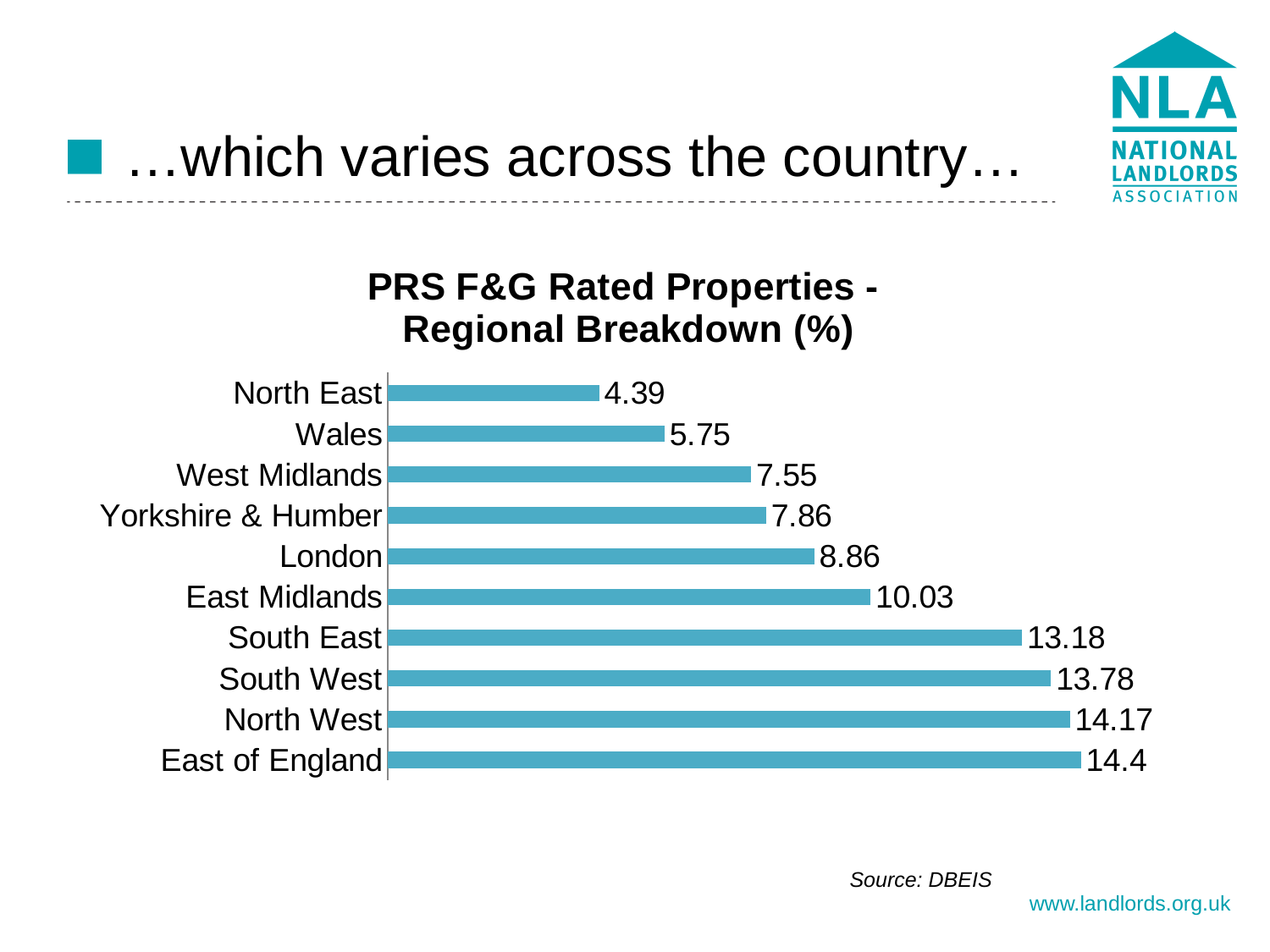
Which region has the highest value? East of England What is the value for South West? 13.78 What is the difference between the values for South East and North East? 8.79 What is the difference between the values for East Midlands and Wales? 4.28 Which region has the lowest value? North East What kind of chart is shown on the slide? Bar chart What is the title of the chart? PRS F&G Rated Properties - Regional Breakdown (%) What is the value for London? 8.86 Which is larger, the value for West Midlands or the value for London? London What is the value for Yorkshire & Humber? 7.86 What source is cited for the chart? DBEIS How many regions are shown in the chart? 10